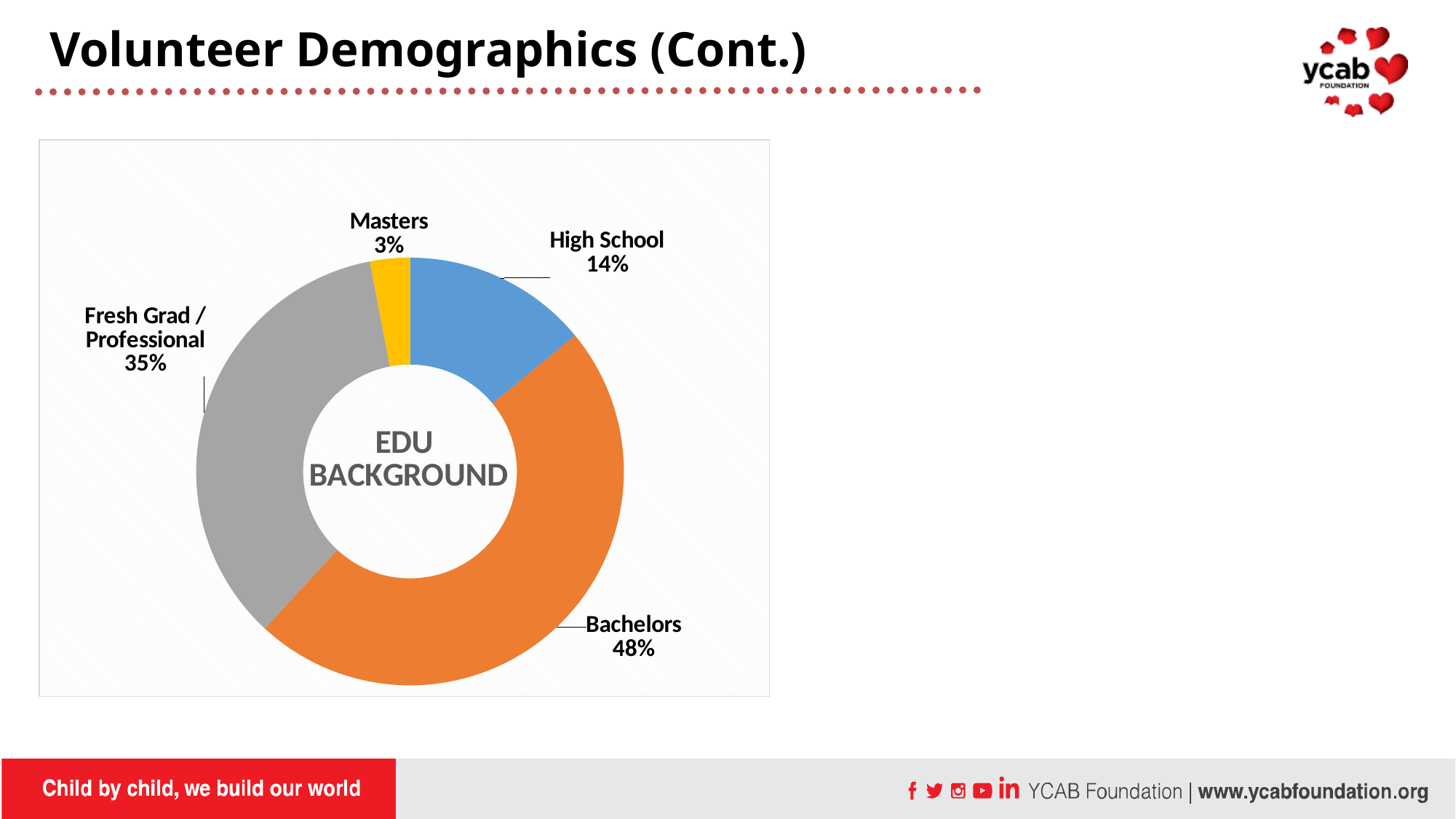
Which education background category has the smallest share? Masters What is the difference in percentage points between High School and Masters? 11 What text appears in the centre of the chart? EDU BACKGROUND Which education background category has the largest share? Bachelors What percentage of volunteers have a Bachelors education background? 48% What kind of chart is shown on the slide? Doughnut (pie) chart How many education background categories are shown in the chart? 4 Which is larger, the share for High School or the share for Masters? High School What percentage of volunteers are in the Fresh Grad / Professional category? 35% What percentage of volunteers have a Masters education background? 3% What percentage of volunteers have a High School education background? 14% What is the difference in percentage points between Bachelors and Fresh Grad / Professional? 13